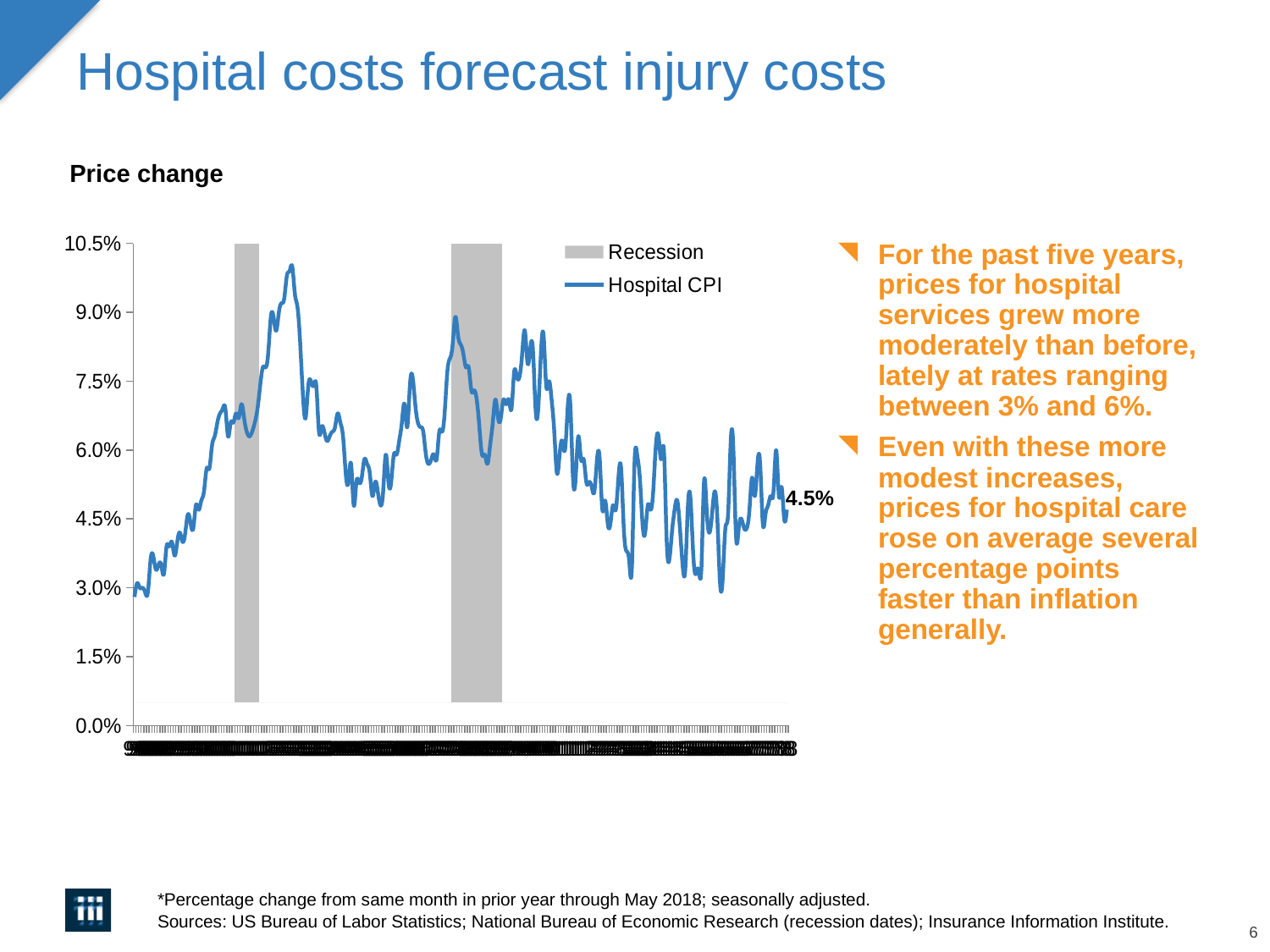
How many entries does the chart's legend list? 2 Is the final labelled value of the Hospital CPI line greater or less than 3.0%? greater Is the final labelled value of the Hospital CPI line greater or less than 6.0%? less What is the highest value shown on the chart's vertical axis? 10.5% What is the most recent value of the Hospital CPI line, as labelled at the right end of the chart? 4.5% How many shaded recession periods are shown on the chart? 2 What kind of chart is shown on the slide? line chart What are the two entries in the chart's legend? Recession and Hospital CPI Is the highest point of the Hospital CPI line greater or less than 9.0%? greater